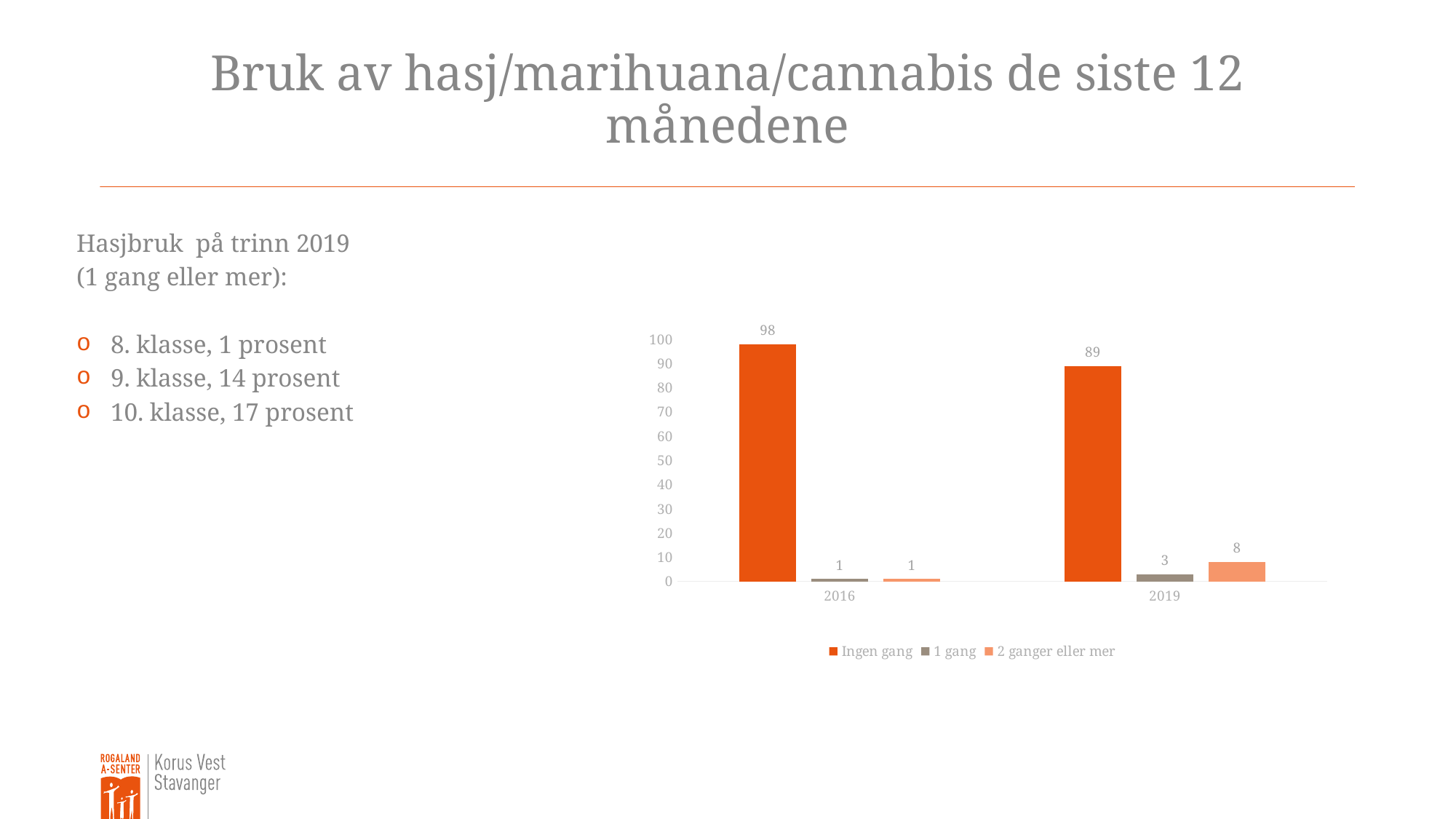
What is the value for "Ingen gang" in 2016? 98 What is the difference between the "Ingen gang" values for 2016 and 2019? 9 Which series is shown in dark orange in the legend? Ingen gang What kind of chart is shown on the slide? Bar chart How many series does the legend list? 3 What is the value for "2 ganger eller mer" in 2019? 8 How many year categories are shown on the x axis? 2 Does the value for "Ingen gang" rise or fall from 2016 to 2019? Fall What is the value for "1 gang" in 2019? 3 What is the value for "1 gang" in 2016? 1 What is the value for "Ingen gang" in 2019? 89 Which year has the higher value for "2 ganger eller mer"? 2019